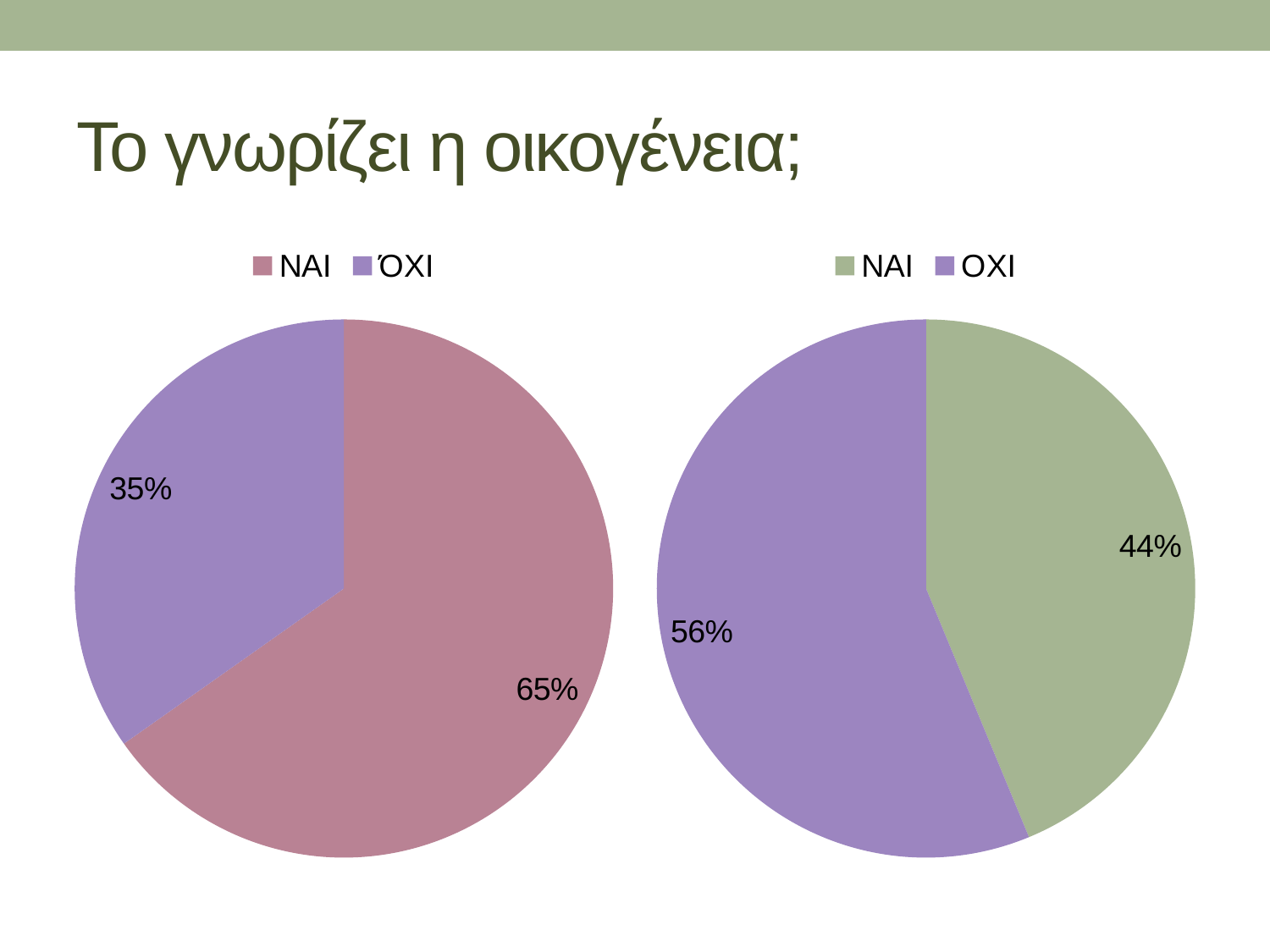
In the right pie chart, what is the difference in percentage points between ΟΧΙ and ΝΑΙ? 12 In the left pie chart, which slice is the largest? ΝΑΙ How many entries does the legend of the left pie chart list? 2 How many slices does the right pie chart have? 2 What kind of chart is the left chart on the slide? Pie chart In the left pie chart, what percentage is shown for ΝΑΙ? 65% In the left pie chart, what percentage is shown for ΌΧΙ? 35% In the right pie chart, what percentage is shown for ΝΑΙ? 44% In the right pie chart, which slice is the smallest? ΝΑΙ In the right pie chart, which is larger, ΝΑΙ or ΟΧΙ? ΟΧΙ In the left pie chart, what is the difference in percentage points between ΝΑΙ and ΌΧΙ? 30 In the right pie chart, what percentage is shown for ΟΧΙ? 56%